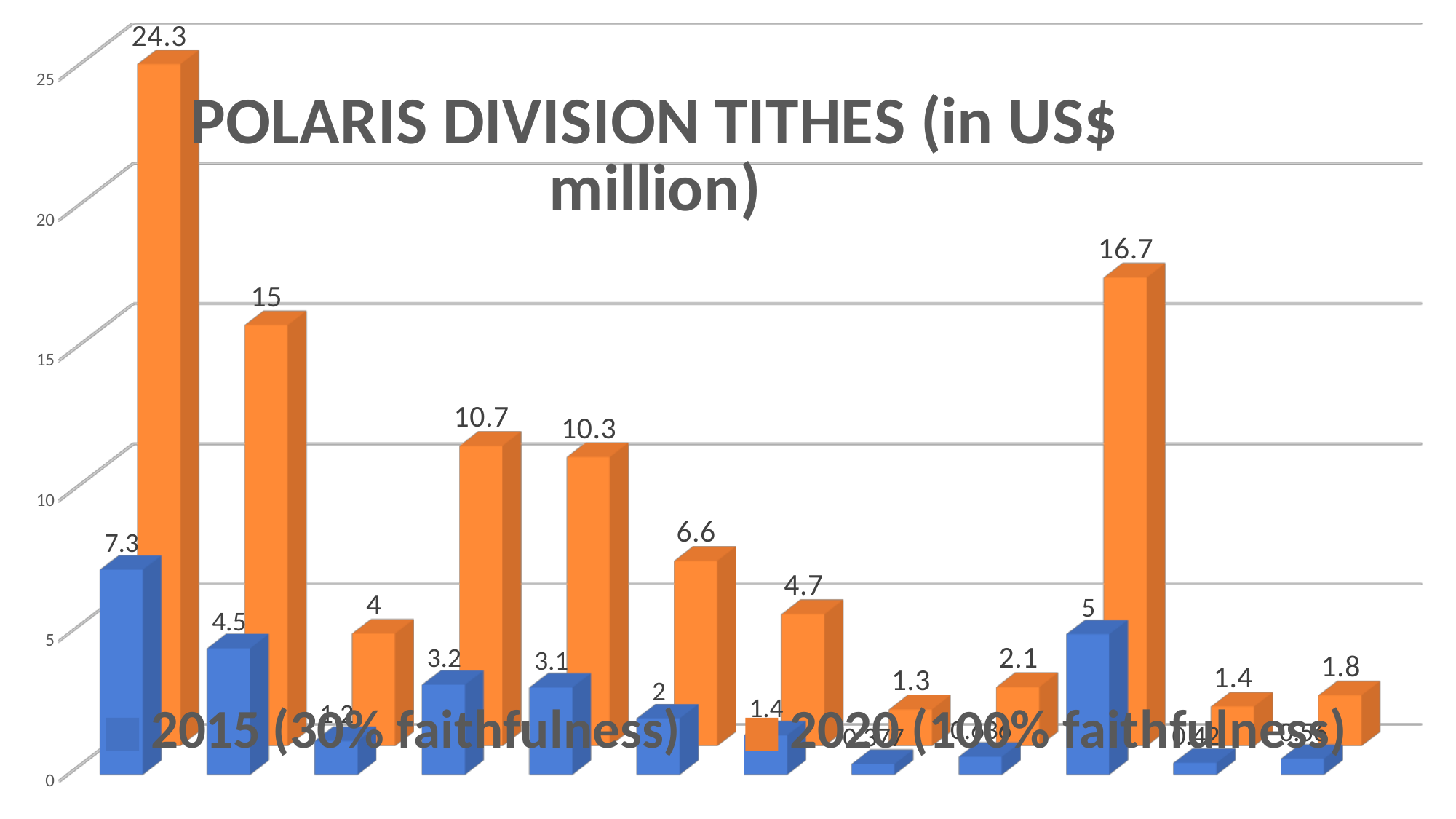
What is the title of the chart? POLARIS DIVISION TITHES (in US$ million) How many series does the legend list? 2 Is the tallest 2020 (100% faithfulness) bar greater or less than 20? greater What is the value of the 2015 (30% faithfulness) bar in the leftmost group? 7.3 What kind of chart is shown on the slide? bar chart In the leftmost group, which series has the larger value, 2015 (30% faithfulness) or 2020 (100% faithfulness)? 2020 (100% faithfulness) How many groups of bars are plotted on the chart? 12 What is the value of the 2020 (100% faithfulness) bar in the leftmost group? 24.3 What is the second-highest value in the 2020 (100% faithfulness) series? 16.7 What is the highest value shown on the chart? 24.3 In the leftmost group, what is the difference between the 2020 (100% faithfulness) value and the 2015 (30% faithfulness) value? 17 Which series is shown in orange? 2020 (100% faithfulness)